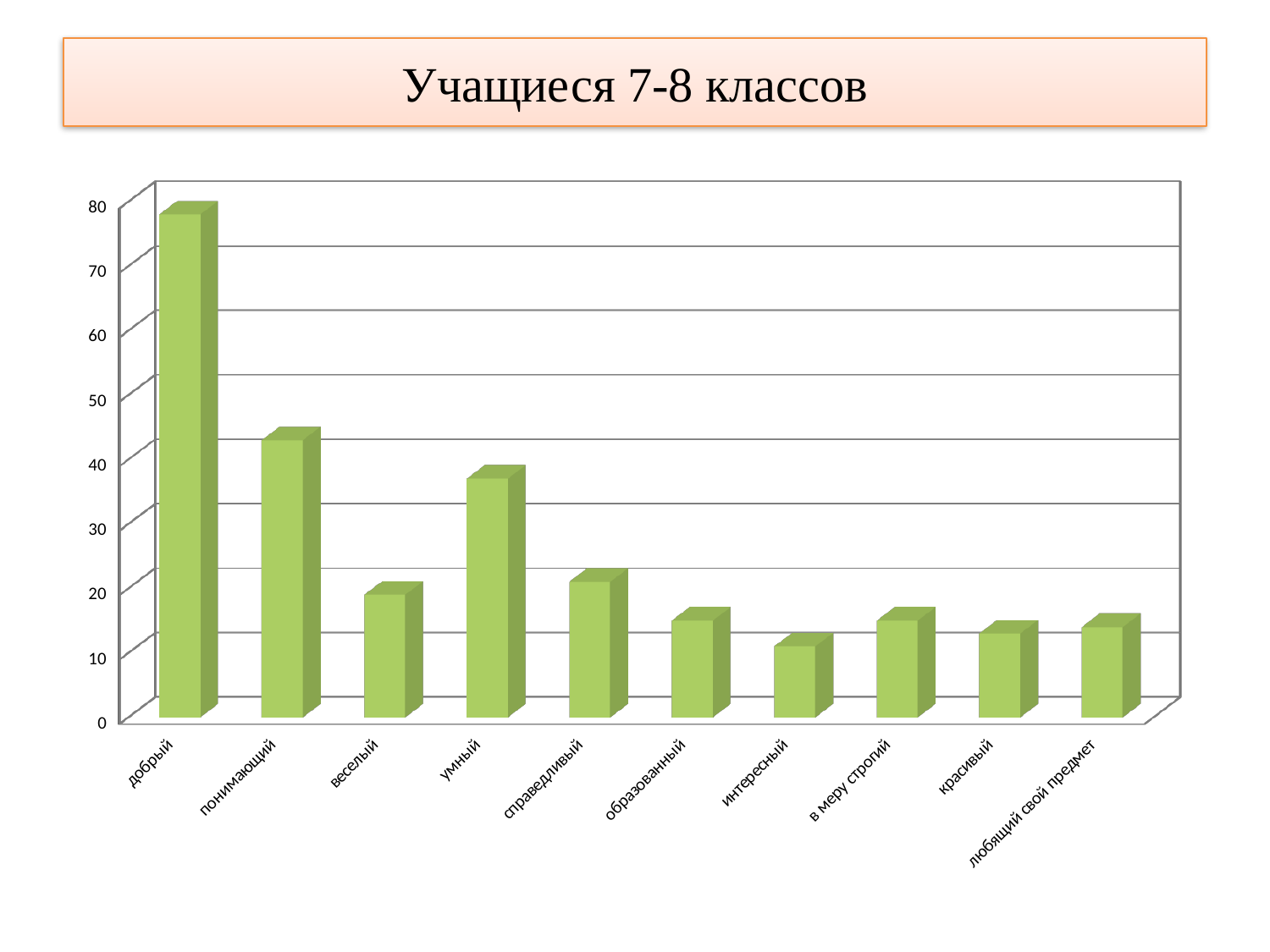
Is the value for умный greater or less than 30? greater Is the value for понимающий greater or less than 40? greater Which category has the lowest bar in the chart? интересный What is the title shown above the chart on the slide? Учащиеся 7-8 классов Which category has the highest bar in the chart? добрый What kind of chart is shown on the slide? bar chart Is the value for справедливый greater or less than 30? less How many categories are shown on the x axis of the chart? 10 Which is larger, the value for справедливый or the value for образованный? справедливый Which is larger, the value for умный or the value for веселый? умный